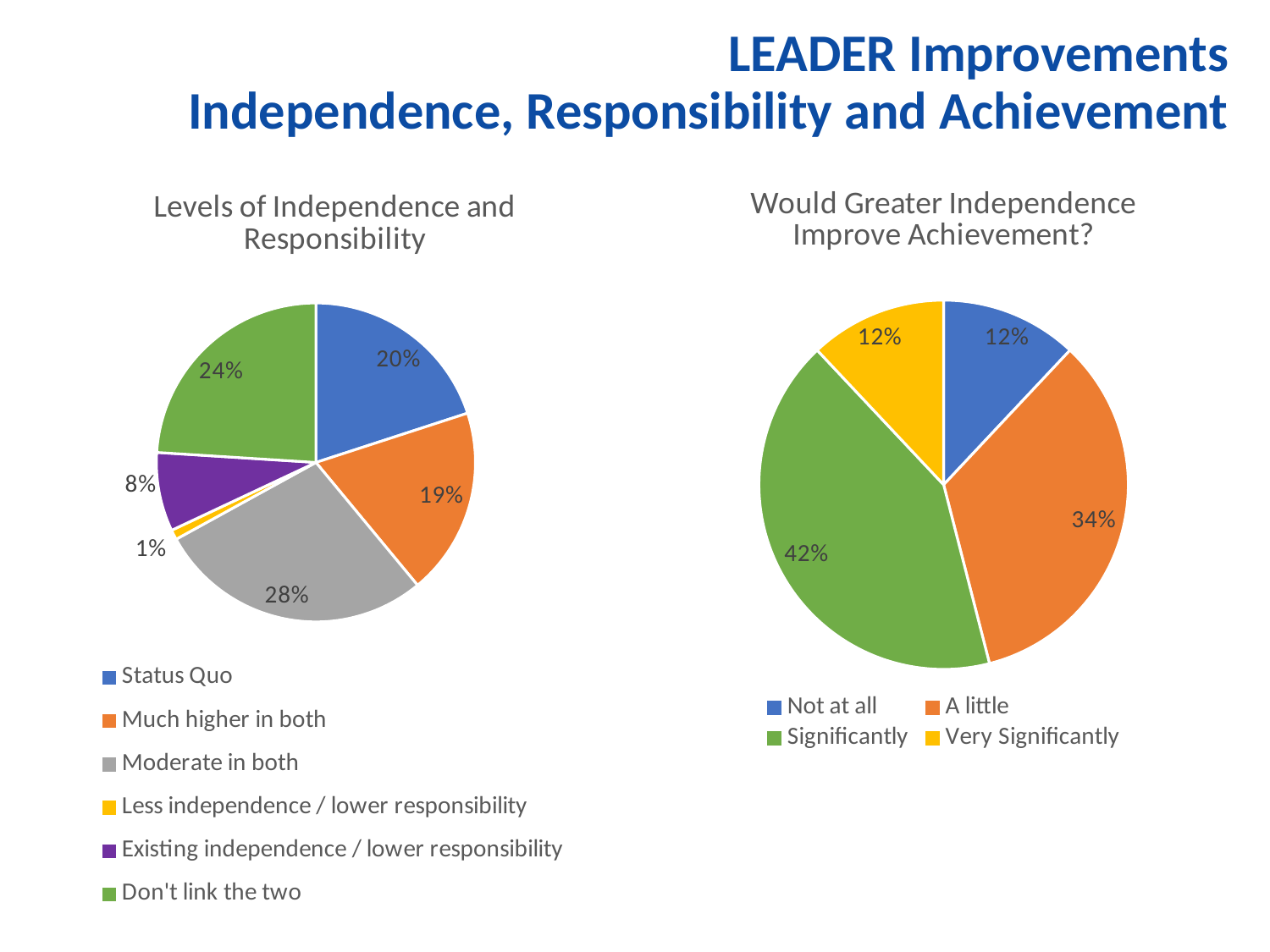
In the 'Would Greater Independence Improve Achievement?' chart, what share is labelled for 'A little'? 34% In the 'Levels of Independence and Responsibility' chart, which category has the largest slice? Moderate in both In the 'Levels of Independence and Responsibility' chart, what share is labelled for 'Moderate in both'? 28% What type of chart is used for 'Would Greater Independence Improve Achievement?'? Pie chart In the 'Levels of Independence and Responsibility' chart, what is the difference between the 'Don't link the two' share and the 'Existing independence / lower responsibility' share? 16% In the 'Would Greater Independence Improve Achievement?' chart, which category has the largest slice? Significantly In the 'Would Greater Independence Improve Achievement?' chart, which is larger: 'A little' or 'Not at all'? A little In the 'Levels of Independence and Responsibility' chart, which category has the smallest slice? Less independence / lower responsibility In the 'Would Greater Independence Improve Achievement?' chart, how many categories does the legend list? 4 In the 'Levels of Independence and Responsibility' chart, how many categories does the legend list? 6 In the 'Would Greater Independence Improve Achievement?' chart, what share is labelled for 'Significantly'? 42% In the 'Levels of Independence and Responsibility' chart, what share is labelled for 'Status Quo'? 20%